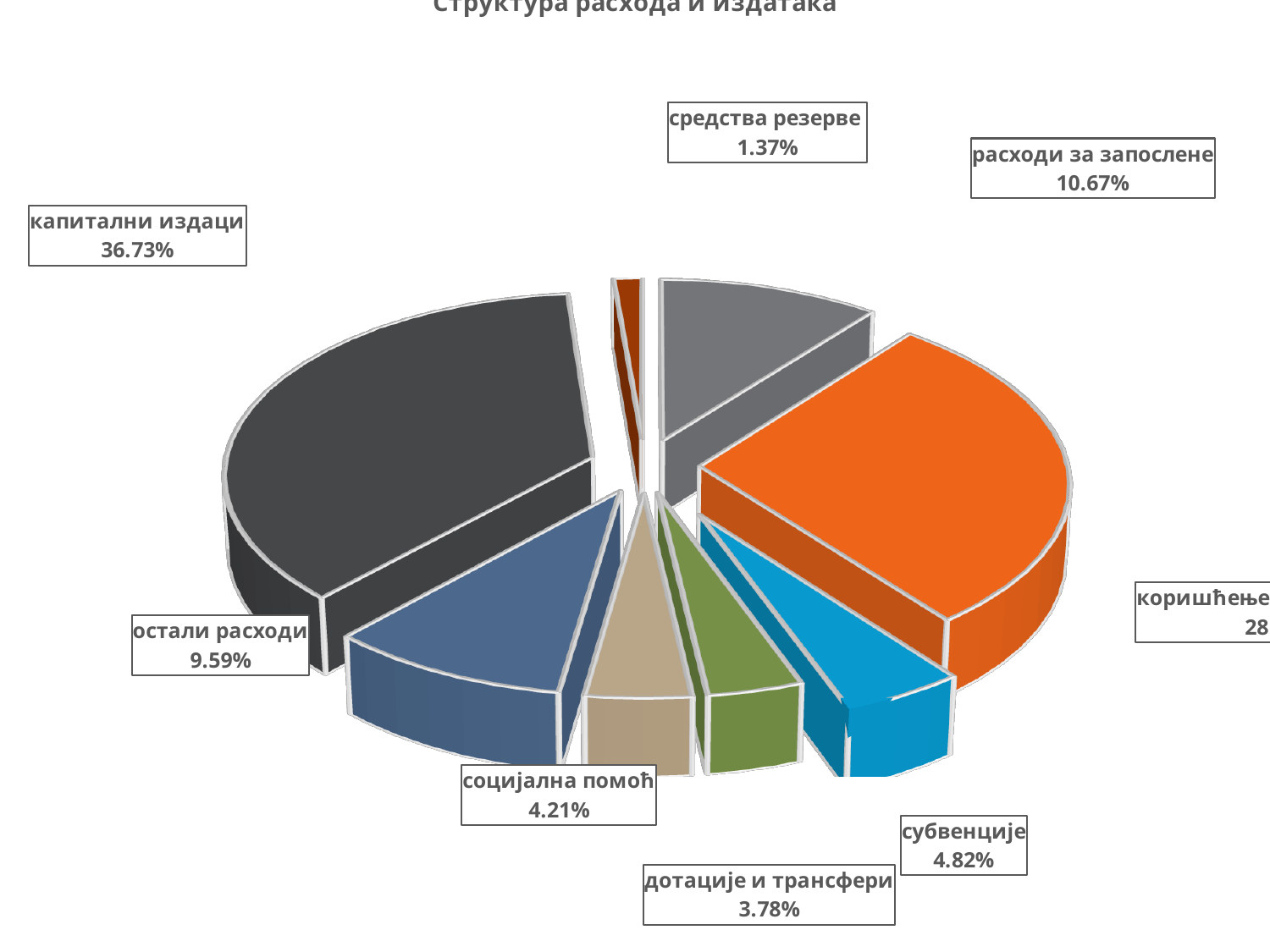
What is the value for дотације и трансфери? 3.78% What kind of chart is shown on the slide? pie chart What is the value shown for расходи за запослене? 10.67% What is the title of the chart? Структура расхода и издатака How many slices does the pie chart have? 8 Which is larger, субвенције or социјална помоћ? субвенције Which category has the largest share of the pie? капитални издаци What share of the pie does капитални издаци represent? 36.73% What percentage is shown for средства резерве? 1.37% What is the difference in percentage points between капитални издаци and расходи за запослене? 26.06 What is the difference in percentage points between остали расходи and субвенције? 4.77 Which category has the smallest share of the pie? средства резерве